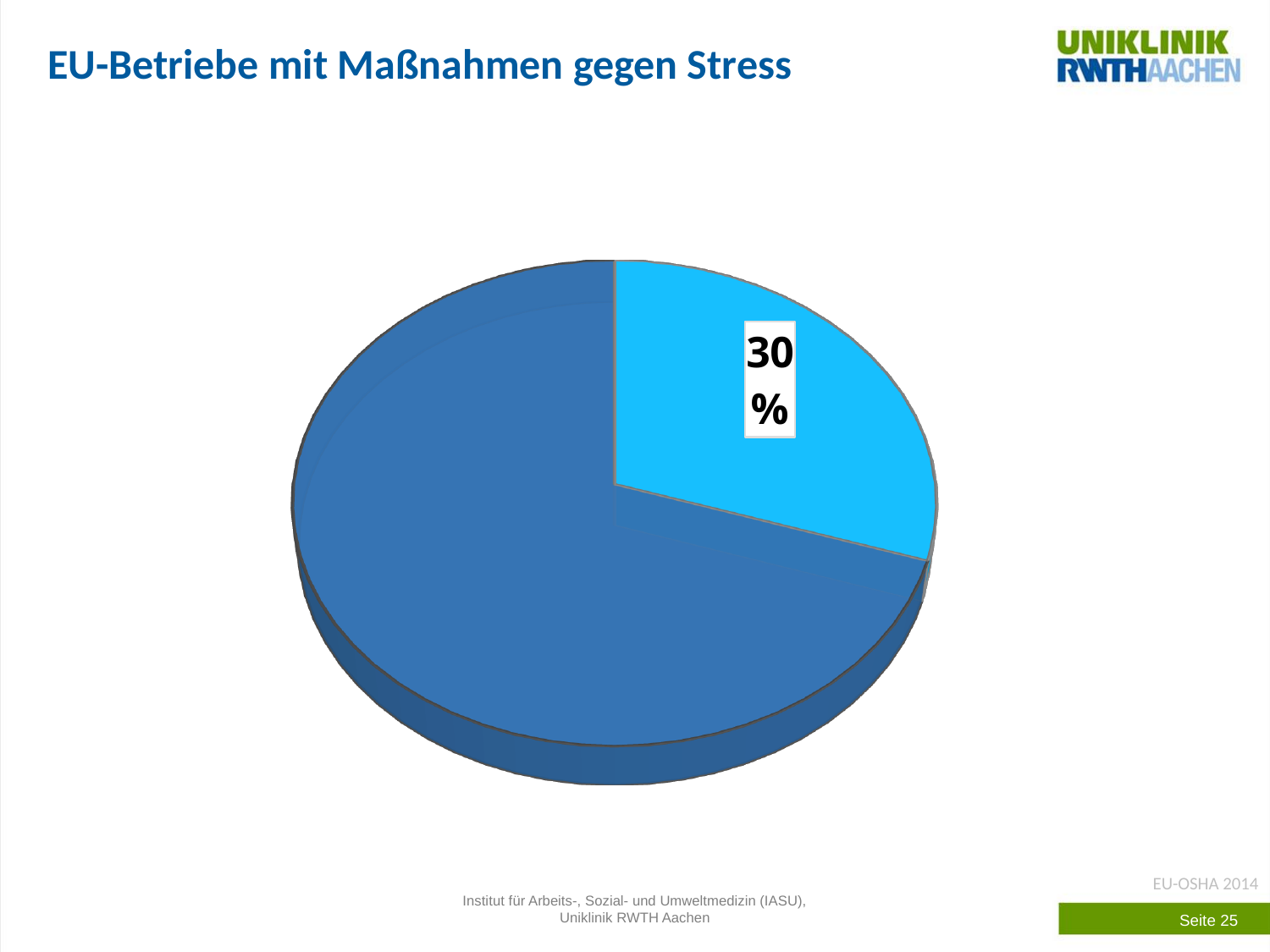
What share of the pie does the light blue slice represent? 30% What colour is the slice that carries the 30% label? light blue Which slice of the pie chart is the smallest? the light blue slice (30%) What percentage is printed on the light blue slice of the pie chart? 30% What kind of chart is shown on the slide? pie chart Which slice of the pie chart is larger, the light blue one or the dark blue one? the dark blue one How many slices of the pie chart have a printed data label? 1 Which slice of the pie chart is the largest? the dark blue slice What is the title of the chart on the slide? EU-Betriebe mit Maßnahmen gegen Stress How many slices does the pie chart have? 2